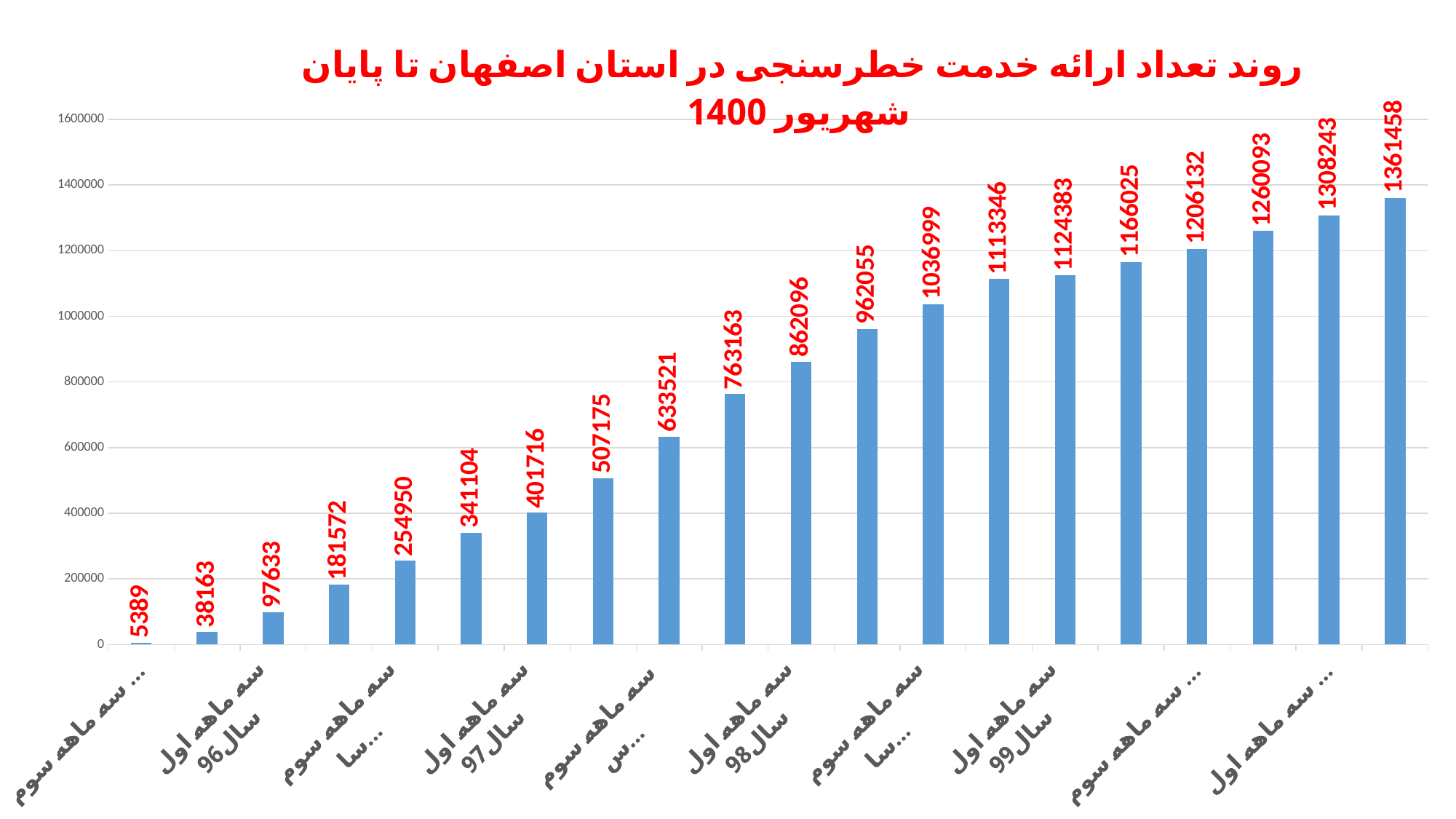
Is the value of the tenth bar from the left greater or less than 800000? less What type of chart is shown on the slide? bar chart Which is larger, the second bar from the left or the third bar from the left? the third bar What is the difference between the last bar (1361458) and the first bar (5389)? 1356069 Do the values rise or fall from left to right along the x axis? rise What is the value of the first (leftmost) bar in the chart? 5389 What is the difference between the last bar (1361458) and the second-to-last bar (1308243)? 53215 What is the lowest value shown in the chart? 5389 What is the value of the last (rightmost) bar in the chart? 1361458 What is the highest value shown in the chart? 1361458 What colour are the data labels above the bars? red How many bars are plotted in the chart? 20